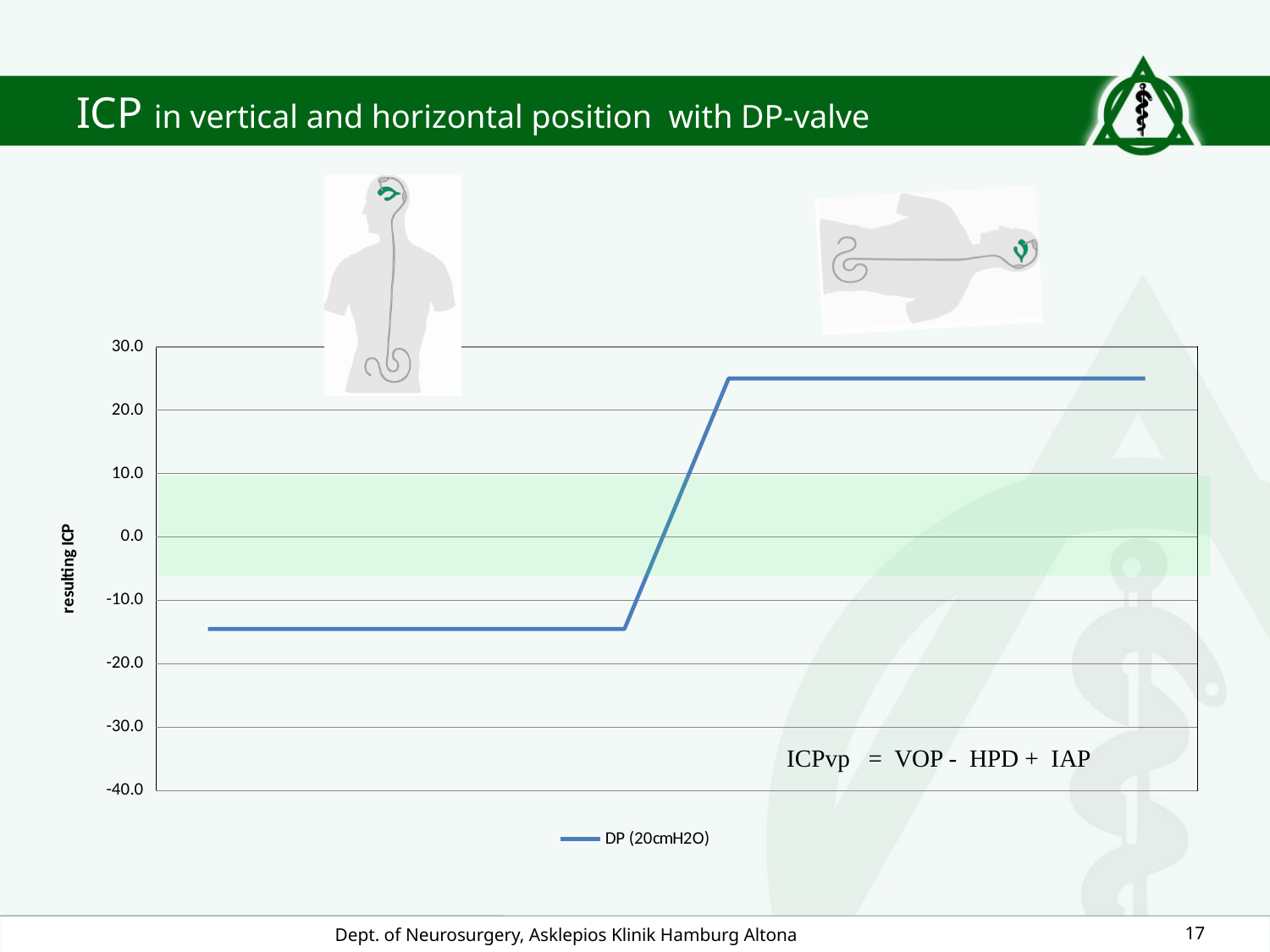
What is the highest tick value shown on the vertical axis? 30.0 What is the lowest tick value shown on the vertical axis? -40.0 Does the DP (20cmH2O) line rise or fall from left to right? rise Is the value of the DP (20cmH2O) line at its left end greater or less than 0.0? less What is the name of the series shown in the legend? DP (20cmH2O) Which part of the DP (20cmH2O) line is higher, the flat section on the left or the flat section on the right? the flat section on the right How many series does the legend list? 1 Is the value of the DP (20cmH2O) line at its right end greater or less than 20.0? greater Is the value of the DP (20cmH2O) line at its right end greater or less than 30.0? less What is the label of the vertical axis? resulting ICP What kind of chart is shown on the slide? line chart